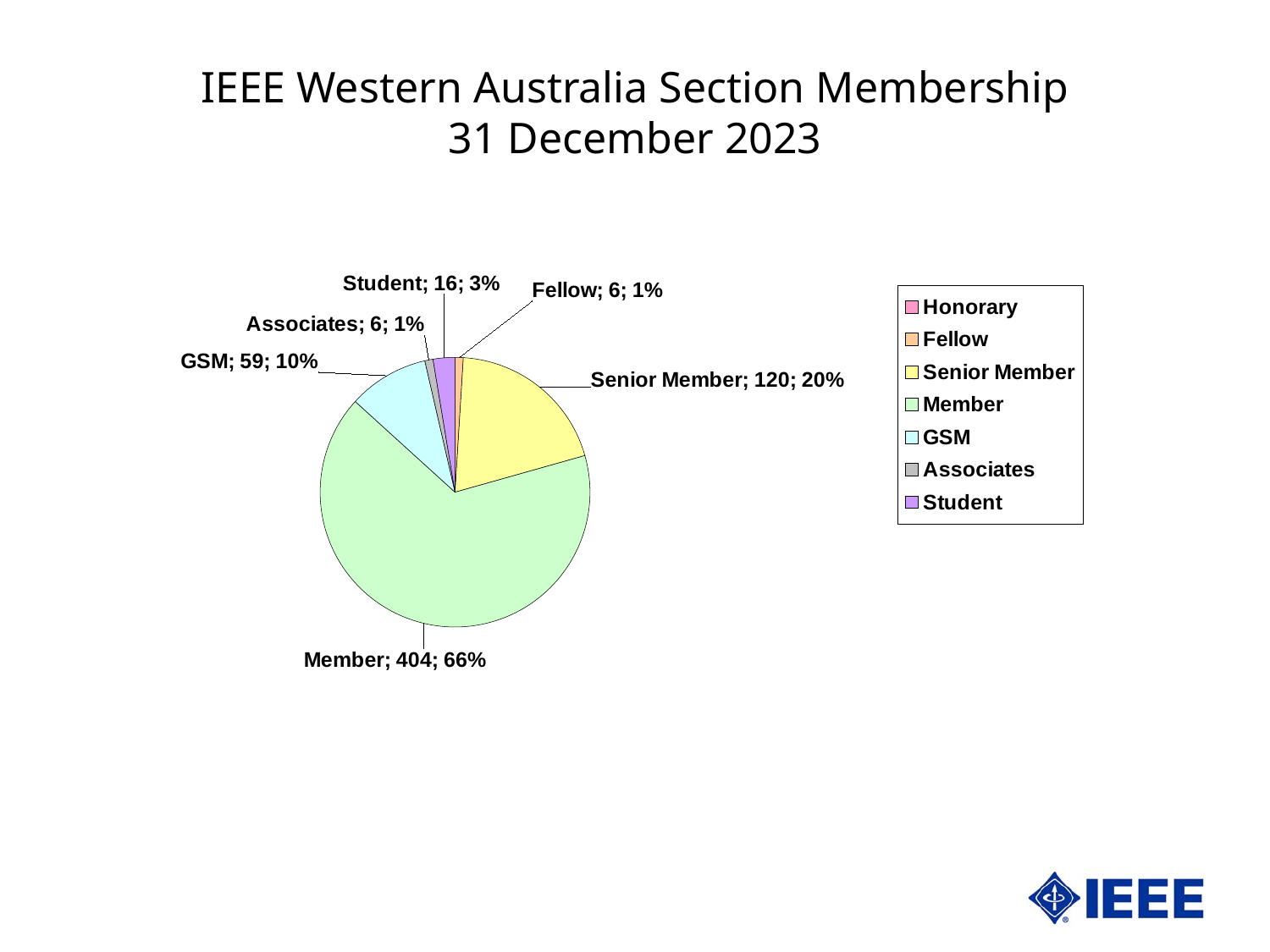
How many members are in the Fellow category? 6 What share of the pie does the Student slice represent? 3% How many members are in the GSM category? 59 Which category has the largest slice of the pie? Member What share of the pie does the Senior Member slice represent? 20% What kind of chart is shown on the slide? pie chart What is the difference between the GSM count and the Student count? 43 What is the title of the slide containing the chart? IEEE Western Australia Section Membership 31 December 2023 Which is larger, the GSM count or the Student count? GSM What is the difference between the Member count and the Senior Member count? 284 How many entries does the legend list? 7 How many members are in the Member category? 404